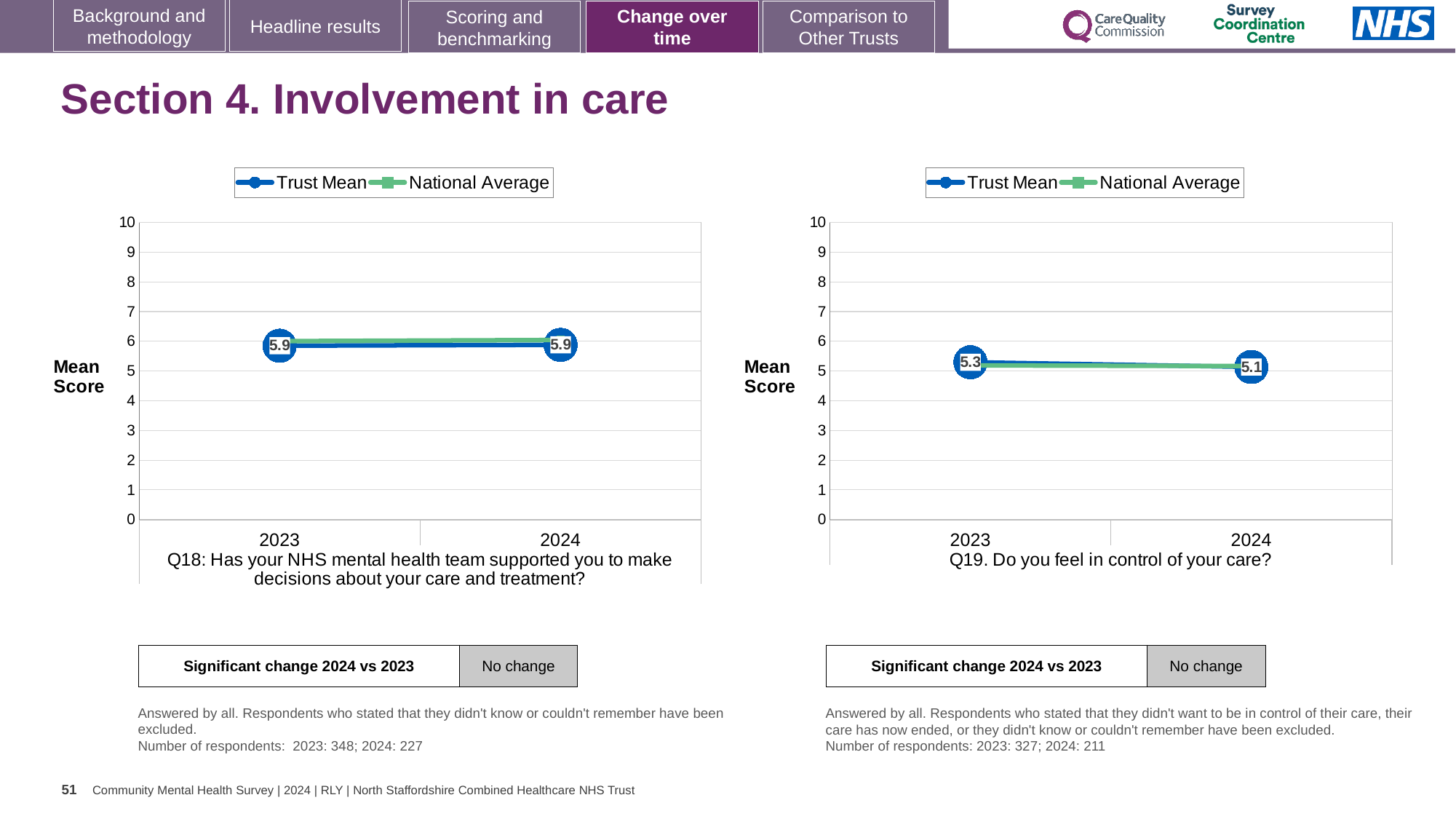
On the Q18 chart (left), what is the Trust Mean for 2024? 5.9 On the Q18 chart (left), what is the Trust Mean for 2023? 5.9 What type of chart is the Q18 chart (left)? line chart On the Q18 chart (left), is the Trust Mean for 2024 greater or less than 5? greater On the Q19 chart (right), which year has the higher Trust Mean, 2023 or 2024? 2023 On the Q19 chart (right), what is the difference between the Trust Mean in 2023 and in 2024? 0.2 How many series does the legend of the Q18 chart (left) list? 2 On the Q19 chart (right), is the Trust Mean for 2024 greater or less than 6? less On the Q19 chart (right), what is the Trust Mean for 2024? 5.1 On the Q19 chart (right), what is the Trust Mean for 2023? 5.3 On the Q19 chart (right), does the Trust Mean rise or fall from 2023 to 2024? fall How many years are plotted on the x axis of the Q19 chart (right)? 2